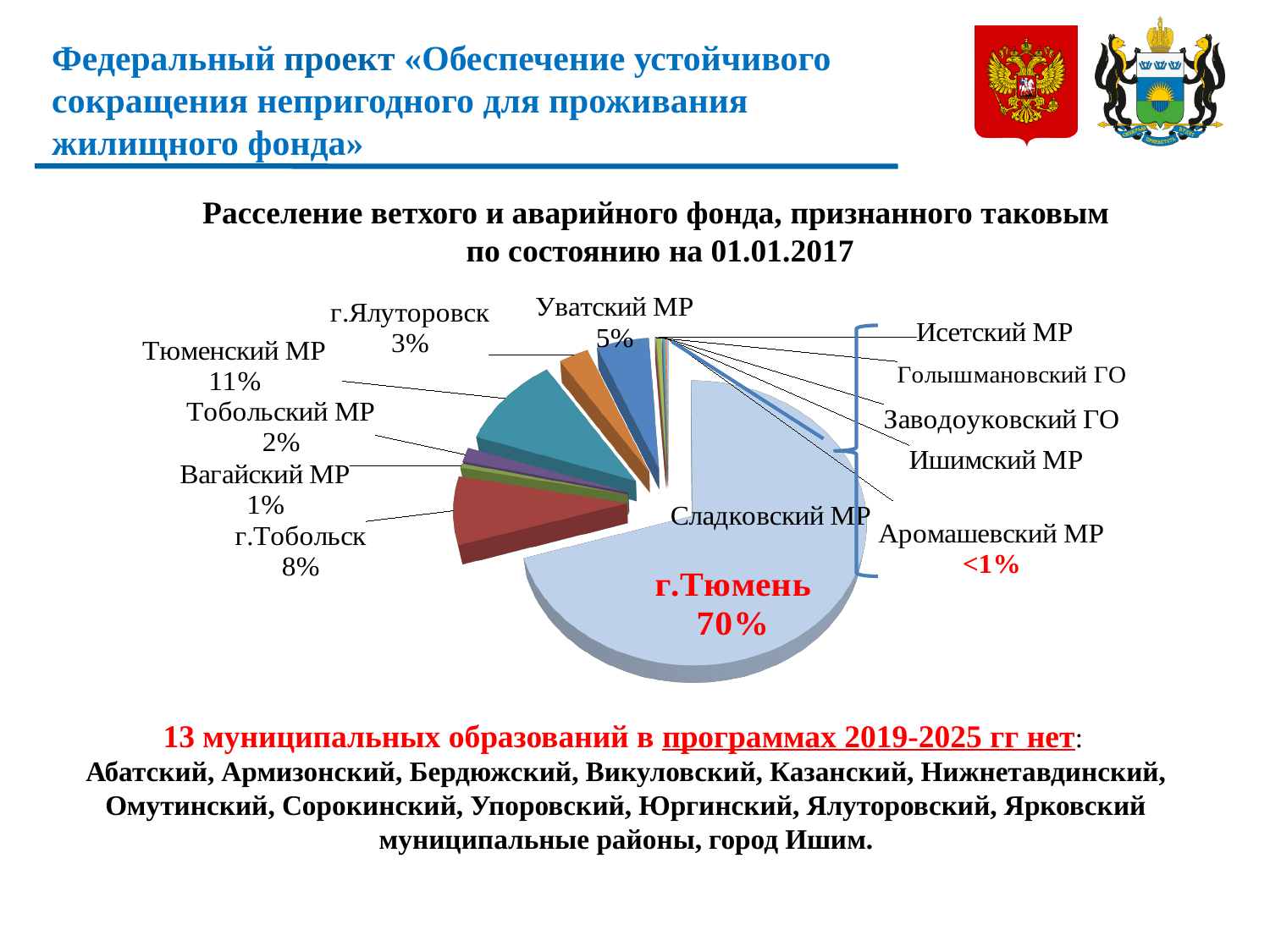
What is the value shown for Уватский МР? 5% What is the value shown for Тобольский МР? 2% What kind of chart is shown on the slide? pie chart What share of the pie does г.Тюмень account for? 70% What is the difference in percentage points between г.Тюмень and Тюменский МР? 59 What is the value shown for Вагайский МР? 1% Which is larger, the share for Тюменский МР or the share for г.Тобольск? Тюменский МР What is the value shown for г.Тобольск? 8% What is the title of the chart? Расселение ветхого и аварийного фонда, признанного таковым по состоянию на 01.01.2017 What is the value shown for Тюменский МР? 11% Which category has the largest slice of the pie? г.Тюмень How many municipalities are grouped together with the label <1%? 6